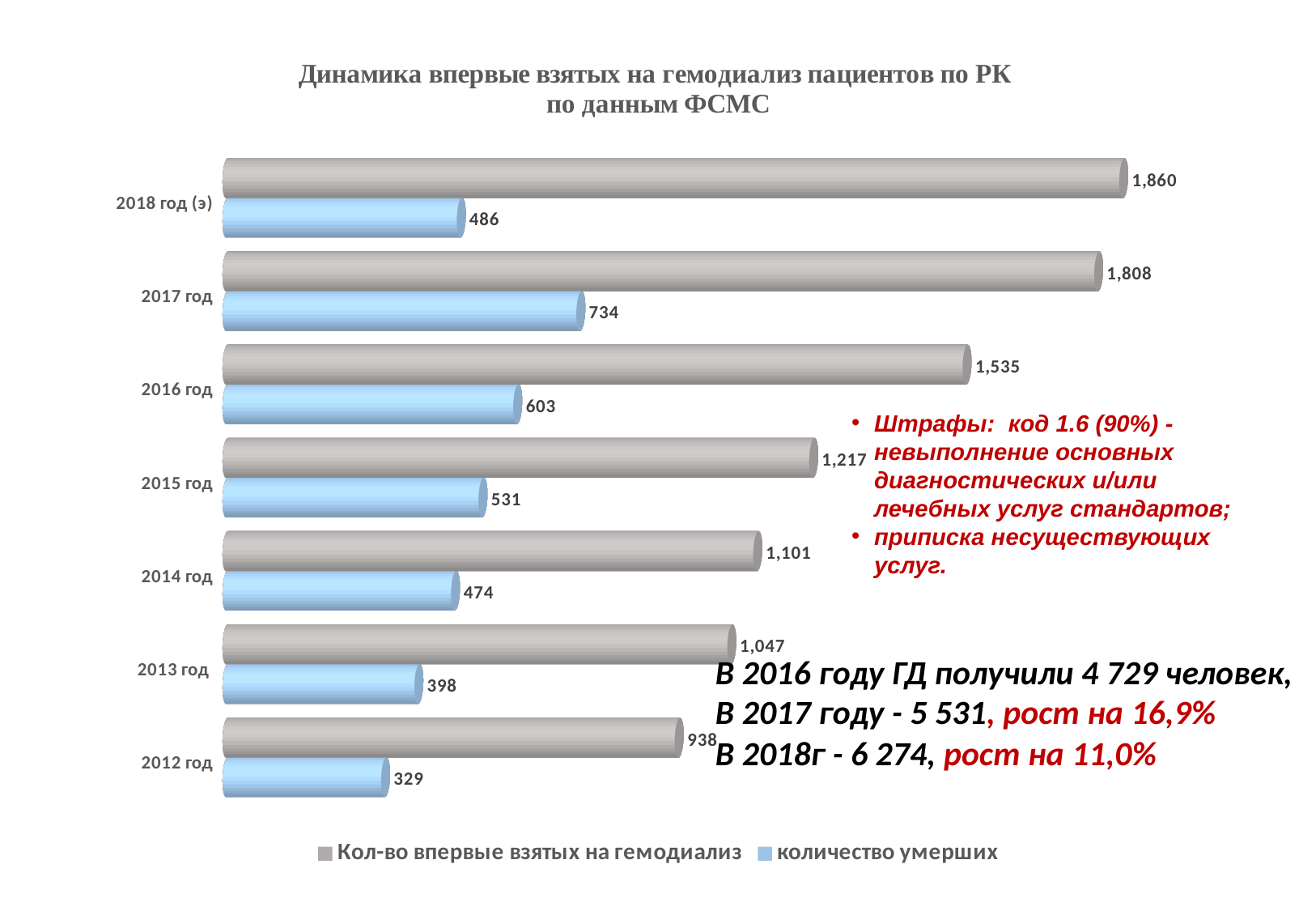
What is the difference between 'количество умерших' in 2017 год and 2016 год? 131 What is the value of 'количество умерших' for 2014 год? 474 What is the value of 'Кол-во впервые взятых на гемодиализ' for 2012 год? 938 Which year has the highest value for 'Кол-во впервые взятых на гемодиализ'? 2018 год (э) Which year has the lowest value for 'количество умерших'? 2012 год What is the value of 'Кол-во впервые взятых на гемодиализ' for 2017 год? 1,808 What is the difference between 'Кол-во впервые взятых на гемодиализ' in 2018 год (э) and 2017 год? 52 How many series does the legend list? 2 How many years are shown on the chart? 7 Which series is shown in blue in the legend? количество умерших What kind of chart is shown on the slide? Bar chart Which is larger: 'количество умерших' in 2017 год or in 2018 год (э)? 2017 год